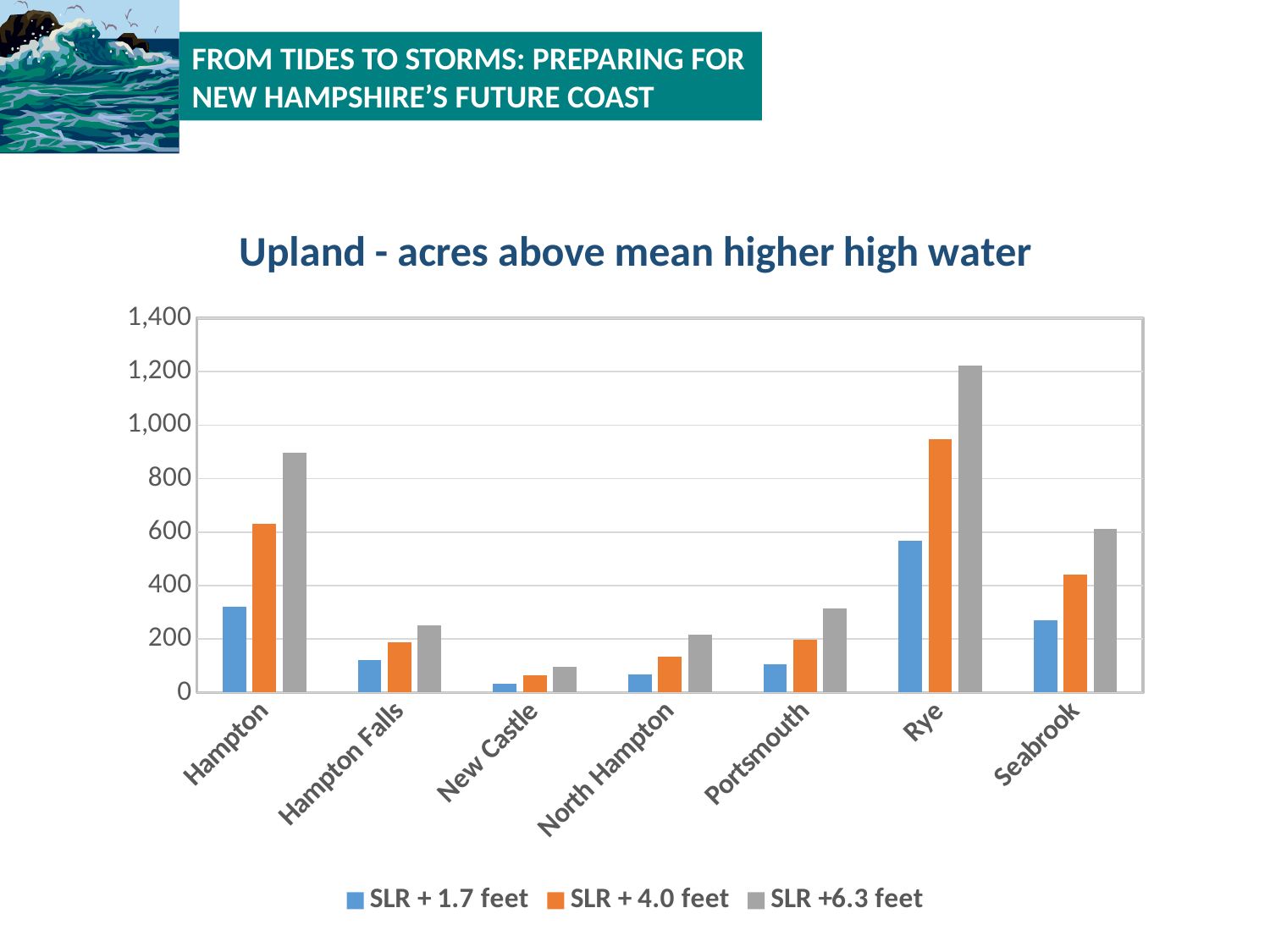
How many towns are shown on the x axis of the chart? 7 Is the SLR + 4.0 feet value for Hampton greater or less than 600? greater Is the SLR +6.3 feet value for Seabrook greater or less than 800? less Is the SLR +6.3 feet value for Rye greater or less than 1,000? greater What type of chart is shown on the slide? Bar chart Which town has the highest value for SLR +6.3 feet? Rye For SLR + 4.0 feet, which town has the larger value, Seabrook or Hampton Falls? Seabrook For SLR +6.3 feet, which town has the larger value, Hampton or Seabrook? Hampton Which town has the lowest value for SLR + 1.7 feet? New Castle What is the title of the chart? Upland - acres above mean higher high water How many series does the legend list? 3